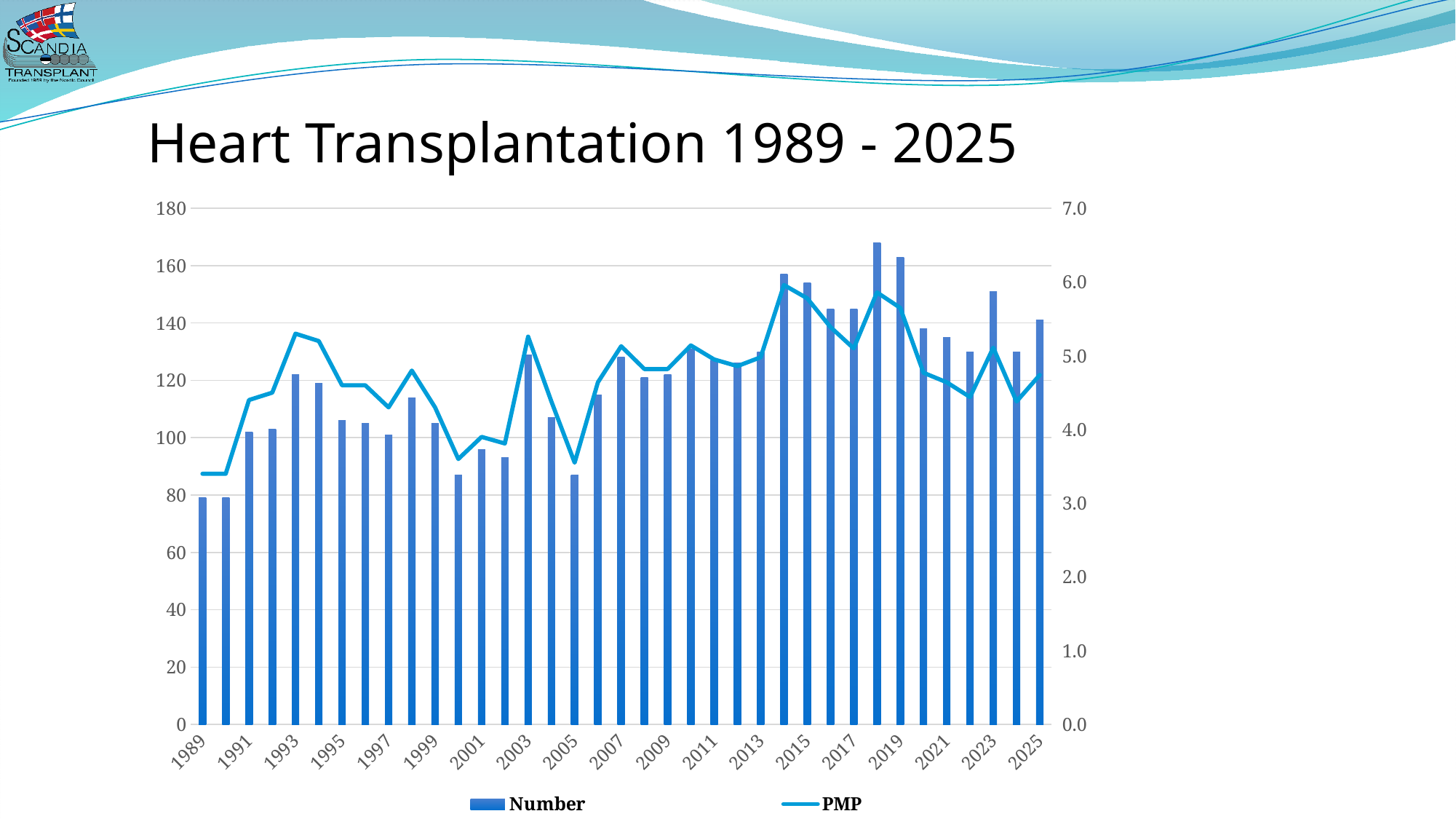
What is the title of the chart on the slide? Heart Transplantation 1989 - 2025 How many series does the legend list? 2 How many years (bars) are plotted on the chart? 37 Is the Number value for 2014 greater or less than 140? greater What are the two series named in the legend? Number and PMP Is the PMP value for 1989 greater or less than 4.0? less Is the Number value for 2005 greater or less than 100? less Which year has the larger Number bar, 2013 or 2014? 2014 What kind of chart is shown on the slide? A bar chart combined with a line chart Which year has the highest Number bar? 2018